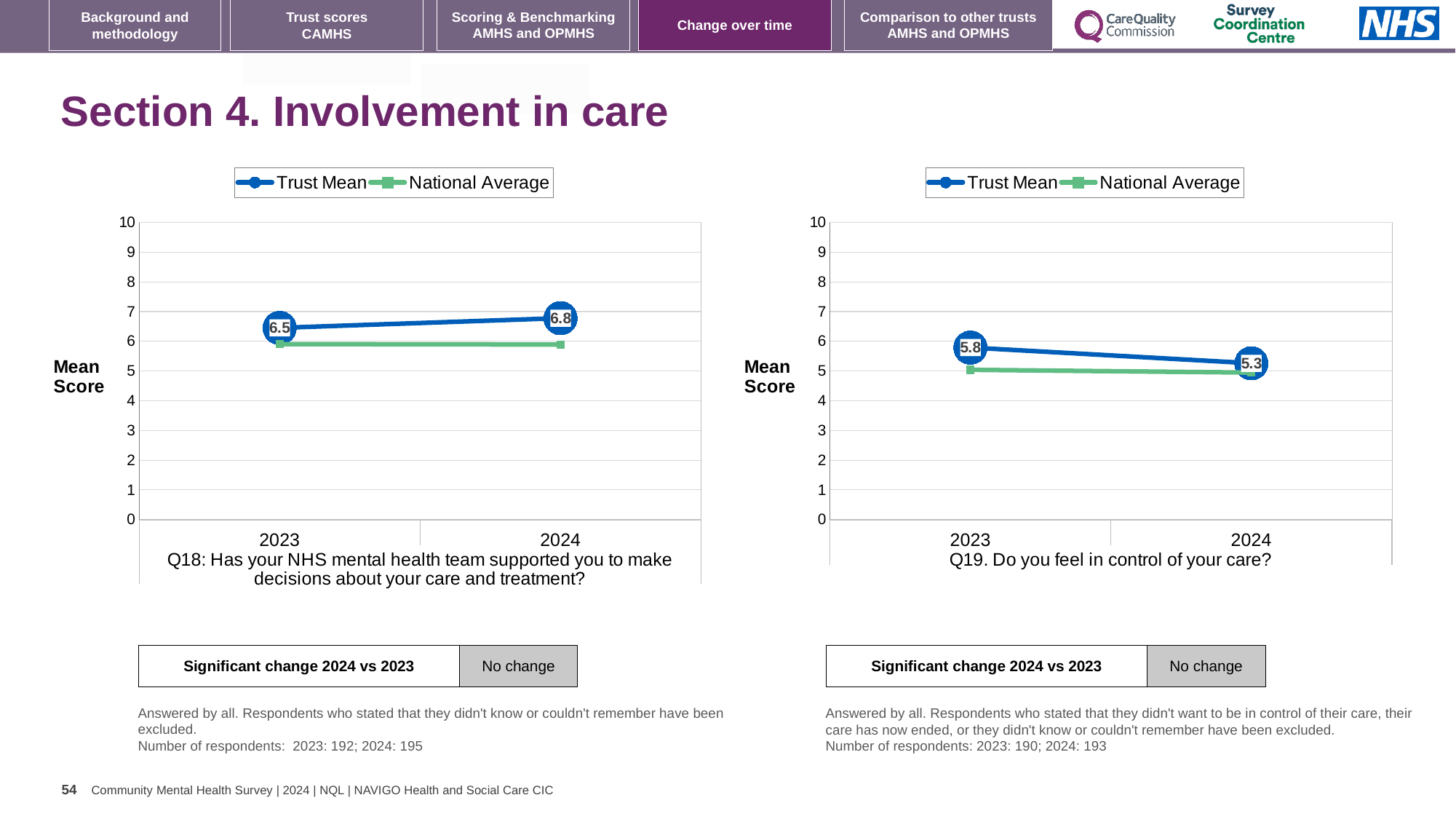
On the Q19 chart (right), what is the difference between the Trust Mean in 2023 and 2024? 0.5 On the Q18 chart (left), by how much did the Trust Mean change from 2023 to 2024? 0.3 On the Q19 chart (right), what is the Trust Mean score for 2024? 5.3 On the Q19 chart (right), which is larger in 2023, the Trust Mean or the National Average? Trust Mean On the Q18 chart (left), is the National Average for 2024 greater or less than 7? less What type of chart is the Q18 chart (left)? line chart On the Q18 chart (left), does the Trust Mean rise or fall from 2023 to 2024? rise On the Q18 chart (left), what is the Trust Mean score for 2024? 6.8 On the Q19 chart (right), what is the Trust Mean score for 2023? 5.8 On the Q18 chart (left), what is the Trust Mean score for 2023? 6.5 On the Q19 chart (right), does the Trust Mean rise or fall from 2023 to 2024? fall How many series does the legend of the Q19 chart (right) list? 2